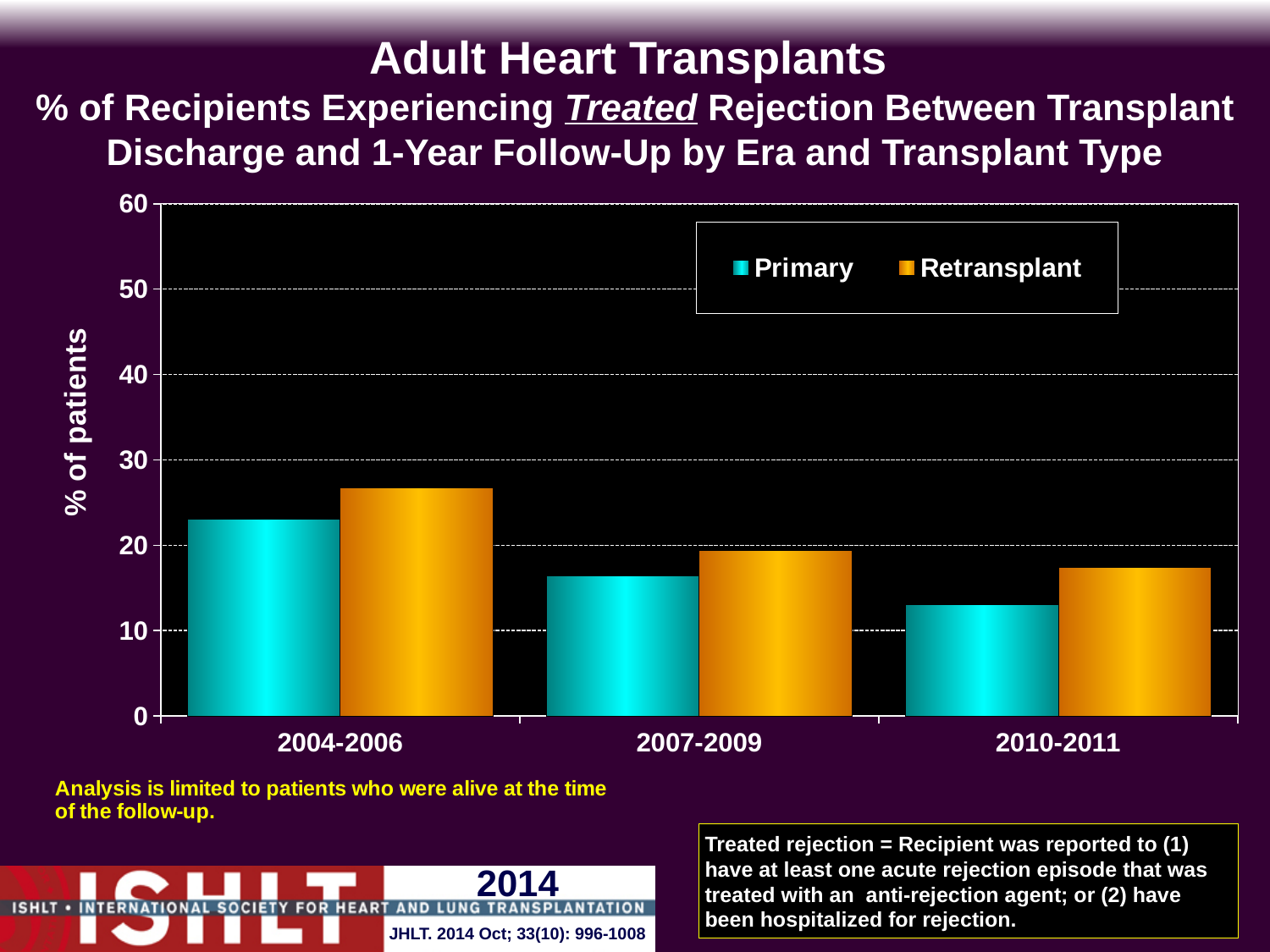
Do the Primary values rise or fall across the eras from 2004-2006 to 2010-2011? fall How many era categories are shown on the x axis? 3 Is the Retransplant value for 2007-2009 greater or less than 20? less What kind of chart is shown on the slide? bar chart In 2010-2011, which is larger: the Primary value or the Retransplant value? Retransplant Which era has the highest value for the Retransplant series? 2004-2006 Which era has the lowest value for the Retransplant series? 2010-2011 Which era has the lowest value for the Primary series? 2010-2011 Is the Primary value for 2004-2006 greater or less than 20? greater What is the label on the y axis? % of patients How many series does the legend list? 2 Which era has the highest value for the Primary series? 2004-2006